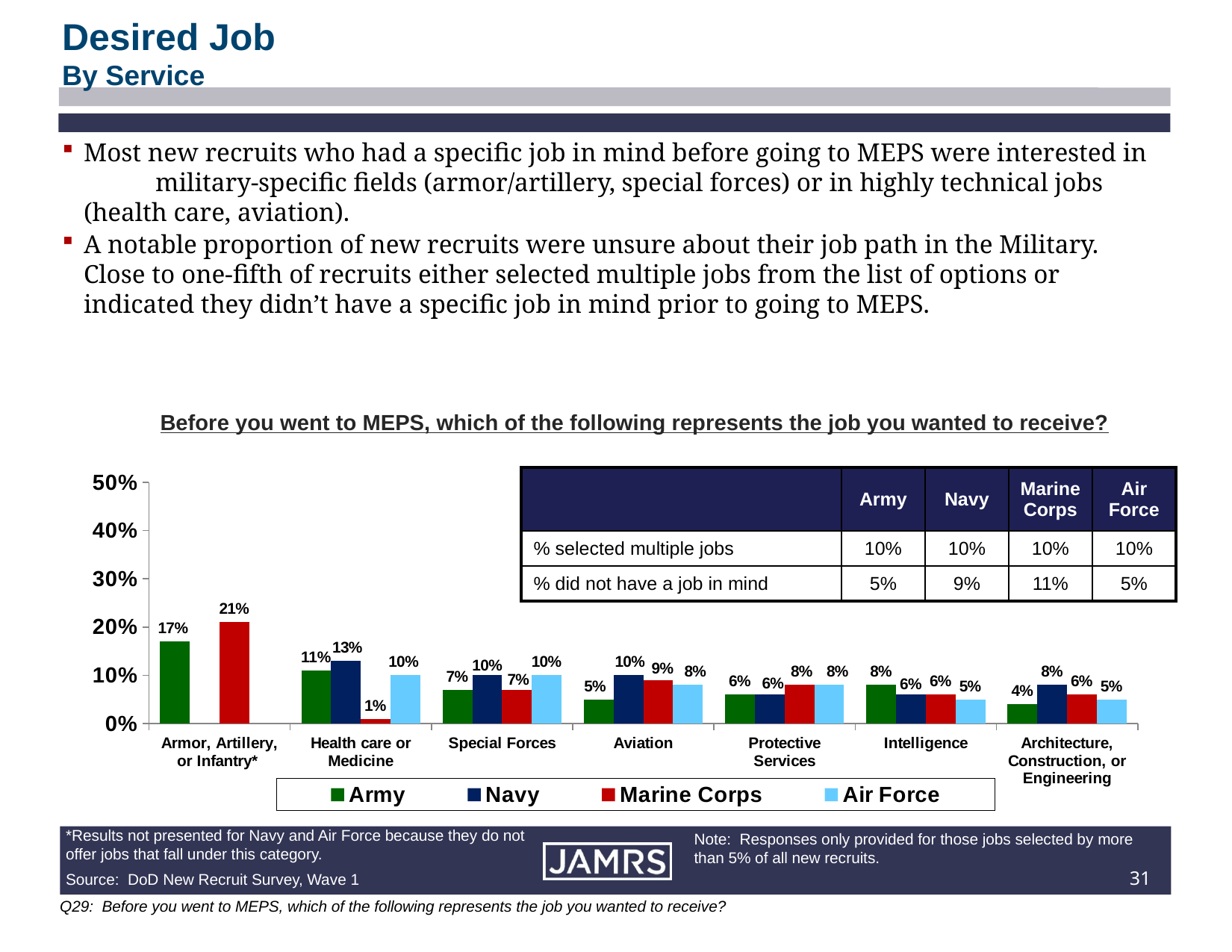
Is the Marine Corps value for Armor, Artillery, or Infantry greater or less than 20%? greater Which is larger for Architecture, Construction, or Engineering: the Navy value or the Army value? Navy What is the difference between the Marine Corps and Army values for Armor, Artillery, or Infantry? 4% Which service has the lowest value for Health care or Medicine? Marine Corps What percentage of Army recruits wanted a job in Aviation? 5% How many job categories are shown on the x axis of the chart? 7 Which service has the highest value for Intelligence? Army In the table on the slide, what percentage of Marine Corps recruits did not have a job in mind? 11% How many series does the chart legend list? 4 What percentage of Marine Corps recruits wanted a job in Armor, Artillery, or Infantry? 21% What percentage of Navy recruits wanted a job in Health care or Medicine? 13% What kind of chart is shown on the slide? Bar chart